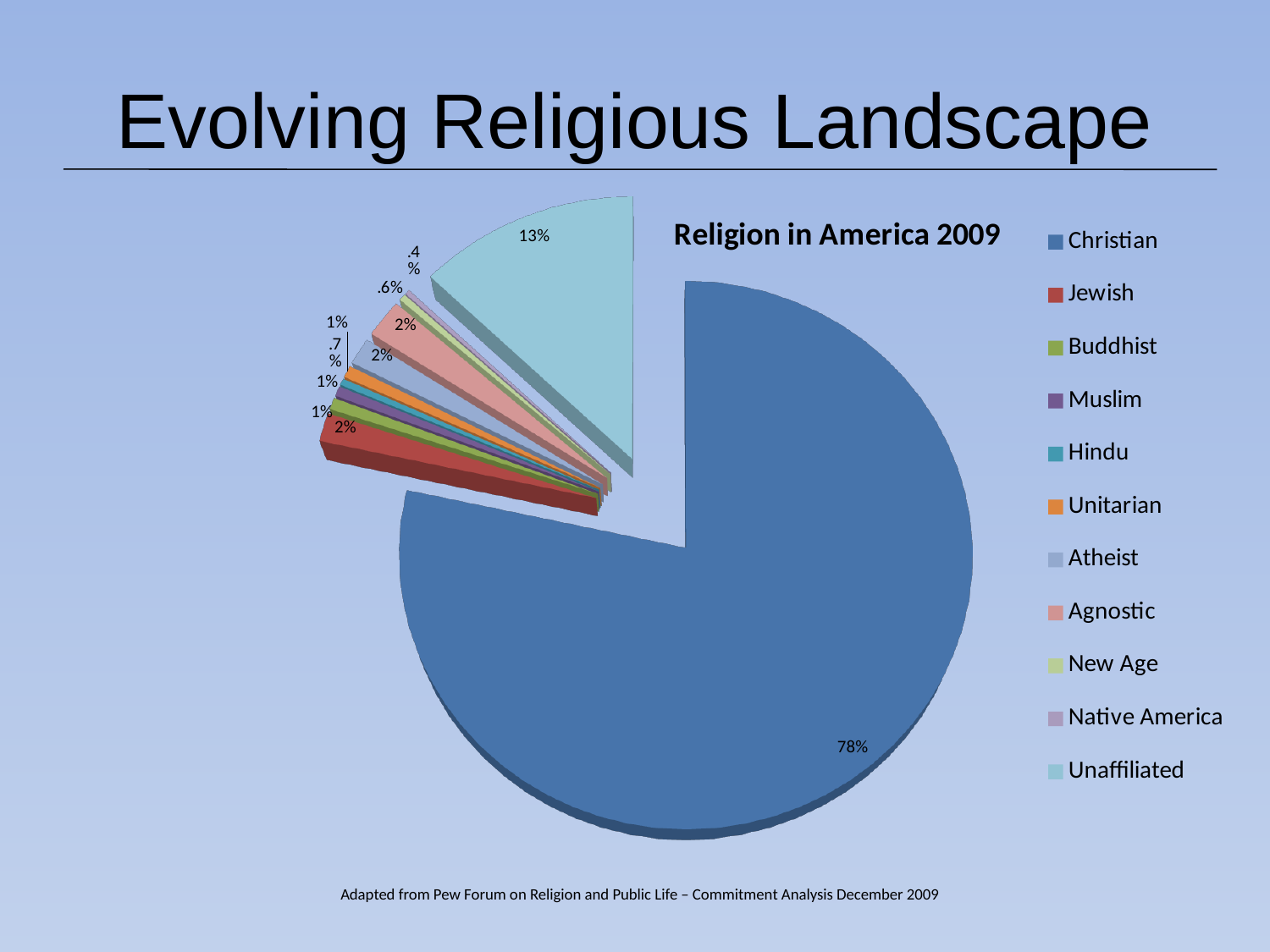
What share of the pie does Unaffiliated represent? 13% What share of the pie does Christian represent? 78% What is the value shown for Jewish? 2% What is the title of the chart? Religion in America 2009 Which category is listed first in the legend? Christian Which is larger, the Christian slice or the Unaffiliated slice? Christian Which category has the largest slice of the pie? Christian Which is larger, the Unaffiliated slice or the Jewish slice? Unaffiliated What kind of chart is shown on the slide? pie chart How many categories does the legend of the pie chart list? 11 What is the difference between the Christian share and the Unaffiliated share? 65%